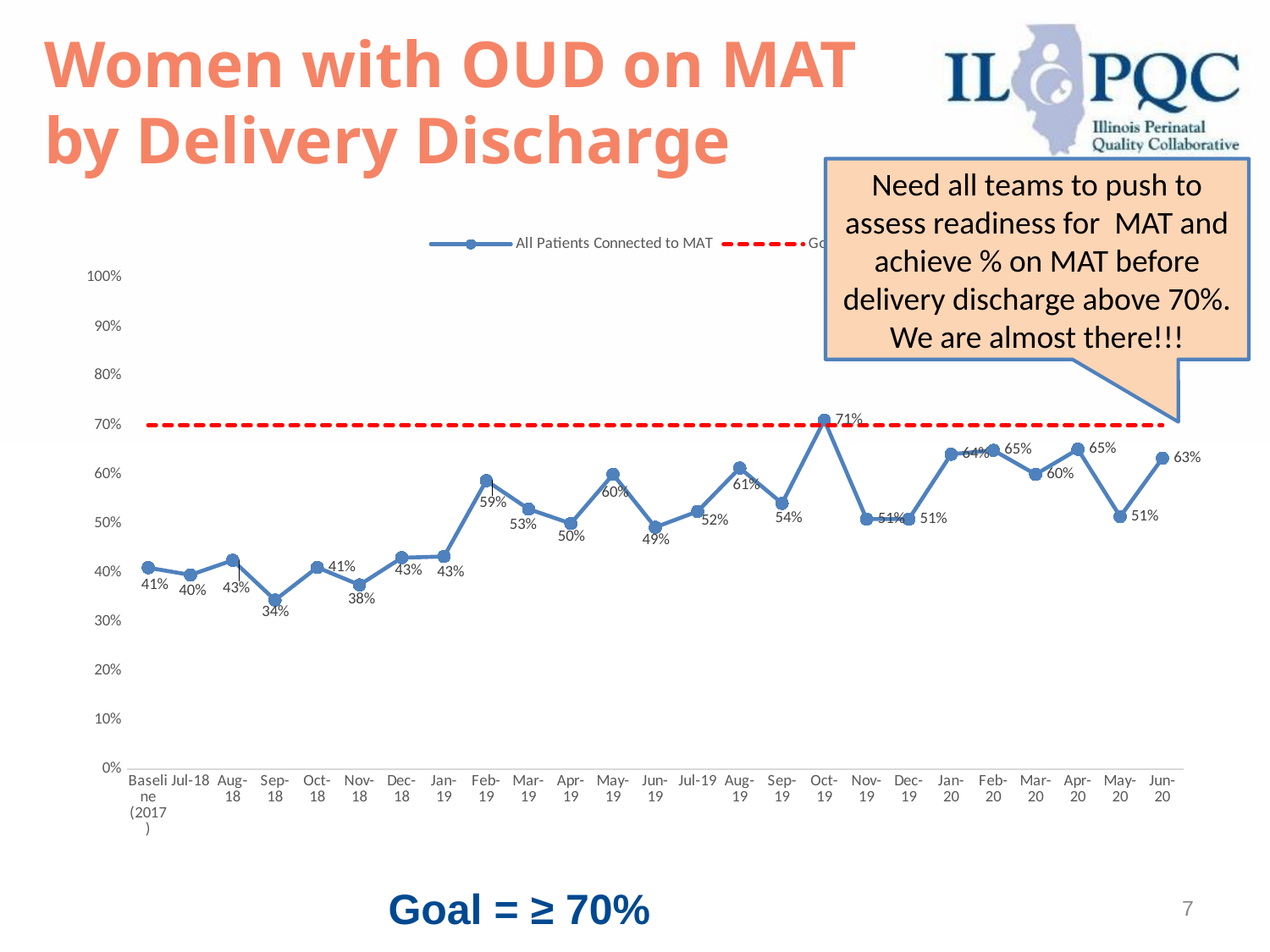
What is the difference between the values for Oct-19 and Nov-19? 20% What is the value for Oct-19? 71% What is the label of the solid blue line series in the legend? All Patients Connected to MAT What is the value for Jun-20? 63% Which month has the lowest percentage of patients connected to MAT? Sep-18 What type of chart is shown on the slide? Line chart What is the value of the dashed red goal line? 70% Which month has the highest percentage of patients connected to MAT? Oct-19 Is the value for Jun-19 greater or less than 70%? less What is the value for Sep-18? 34% What is the value for Feb-19? 59% Which is larger, the value for Apr-20 or the value for May-20? Apr-20